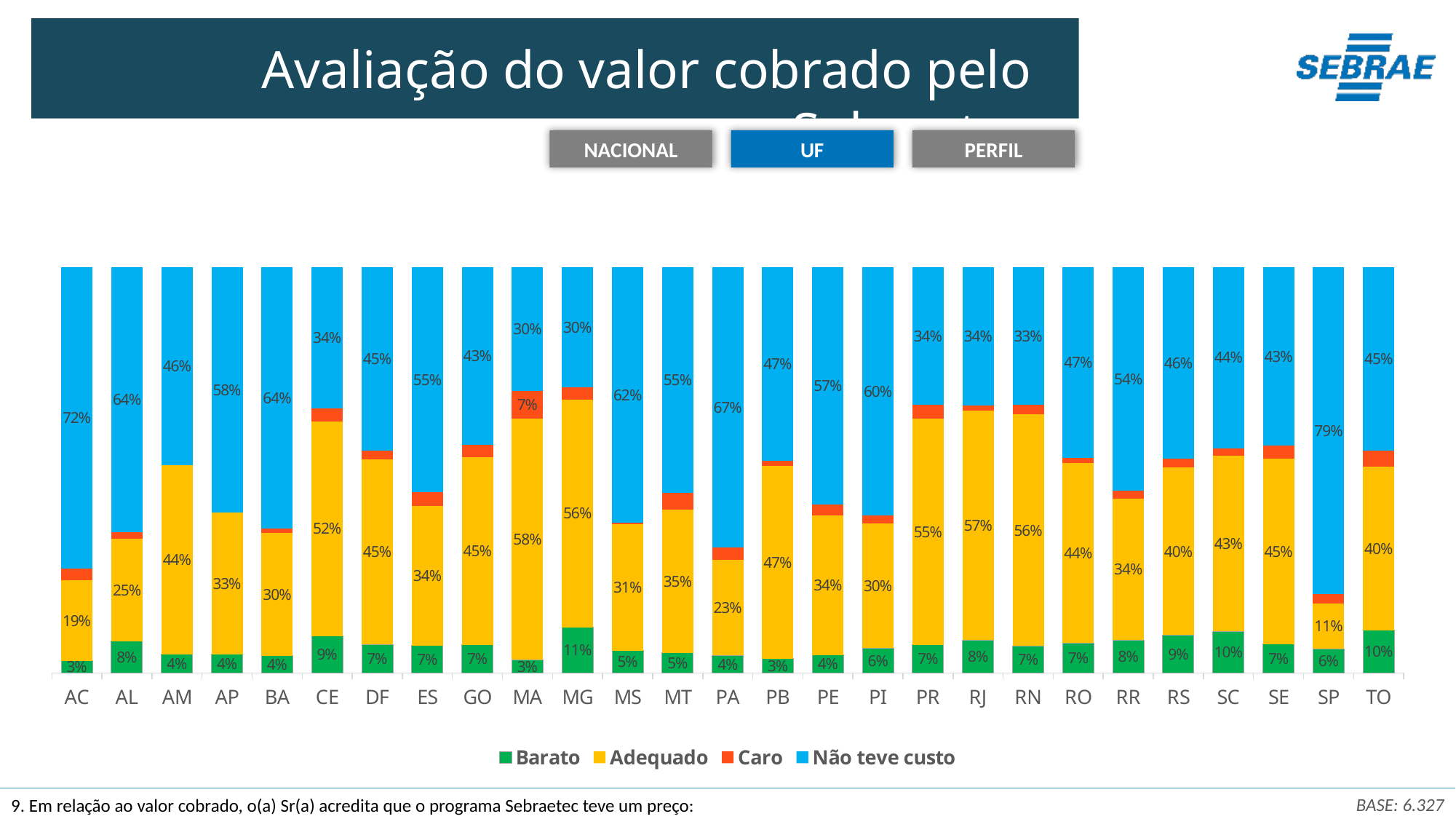
How many series does the legend list? 4 How many states (categories) are shown on the x axis? 27 What is the 'Caro' value for MA? 7% What kind of chart is shown on the slide? Stacked bar chart What is the 'Adequado' value for MA? 58% What is the difference between the 'Não teve custo' values for SP and AC? 7 percentage points Which state has the lowest 'Adequado' value? SP What is the 'Barato' value for MG? 11% What are the four legend entries of the chart? Barato, Adequado, Caro, Não teve custo Which state has the highest 'Não teve custo' value? SP What is the 'Não teve custo' value for SP? 79% Which is larger, the 'Adequado' value for RJ or for RS? RJ